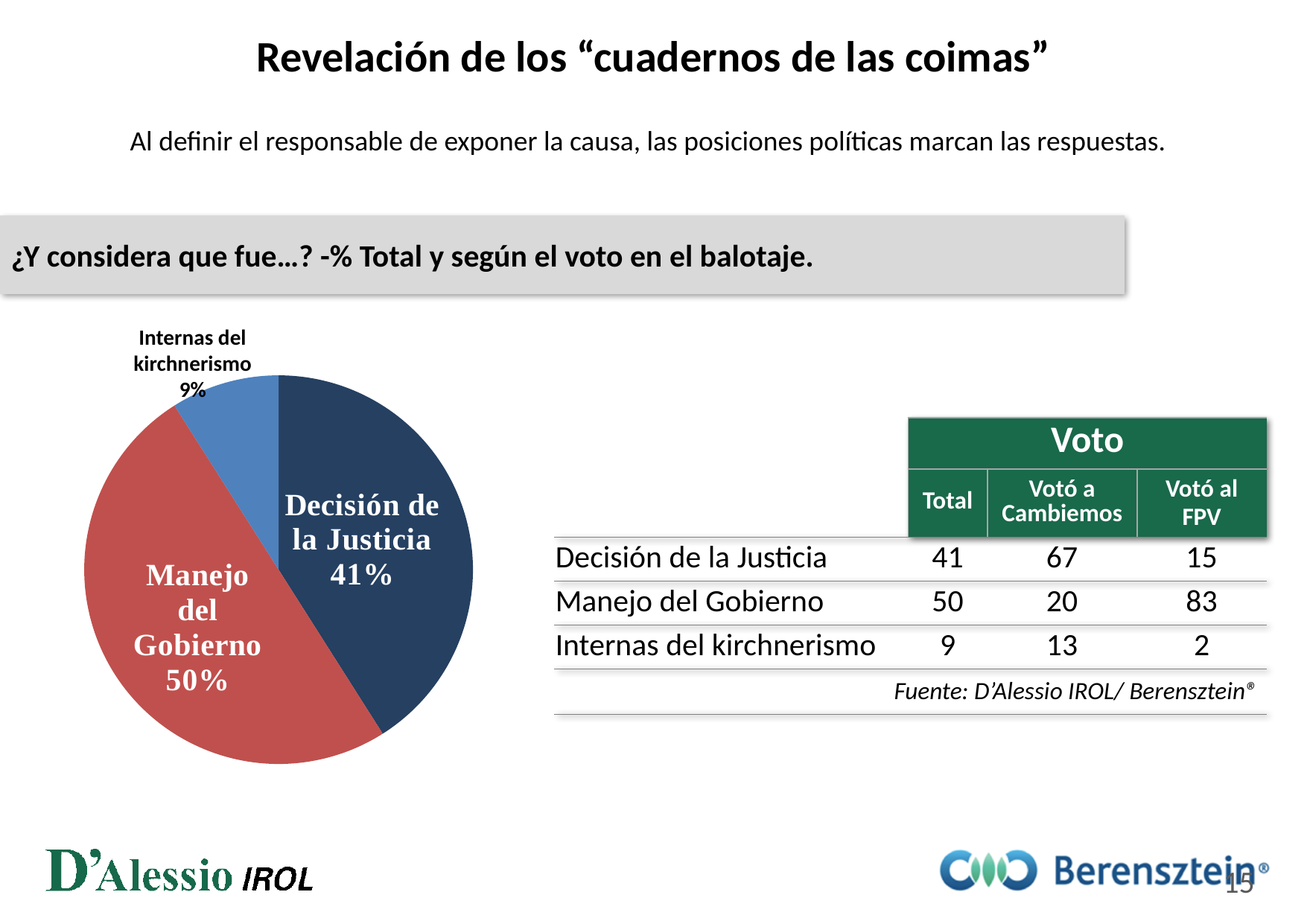
What kind of chart is shown on the slide? pie chart What colour is the "Manejo del Gobierno" slice in the pie chart? red What colour is the "Decisión de la Justicia" slice in the pie chart? dark blue Which slice of the pie chart is the largest? Manejo del Gobierno What share of the pie does "Decisión de la Justicia" hold? 41% What share of the pie does "Internas del kirchnerismo" hold? 9% What share of the pie does "Manejo del Gobierno" hold? 50% Which is larger in the pie chart: "Decisión de la Justicia" or "Internas del kirchnerismo"? Decisión de la Justicia What is the difference in percentage points between the "Decisión de la Justicia" slice and the "Internas del kirchnerismo" slice? 32 How many slices does the pie chart have? 3 What is the difference in percentage points between the "Manejo del Gobierno" slice and the "Decisión de la Justicia" slice? 9 Which slice of the pie chart is the smallest? Internas del kirchnerismo